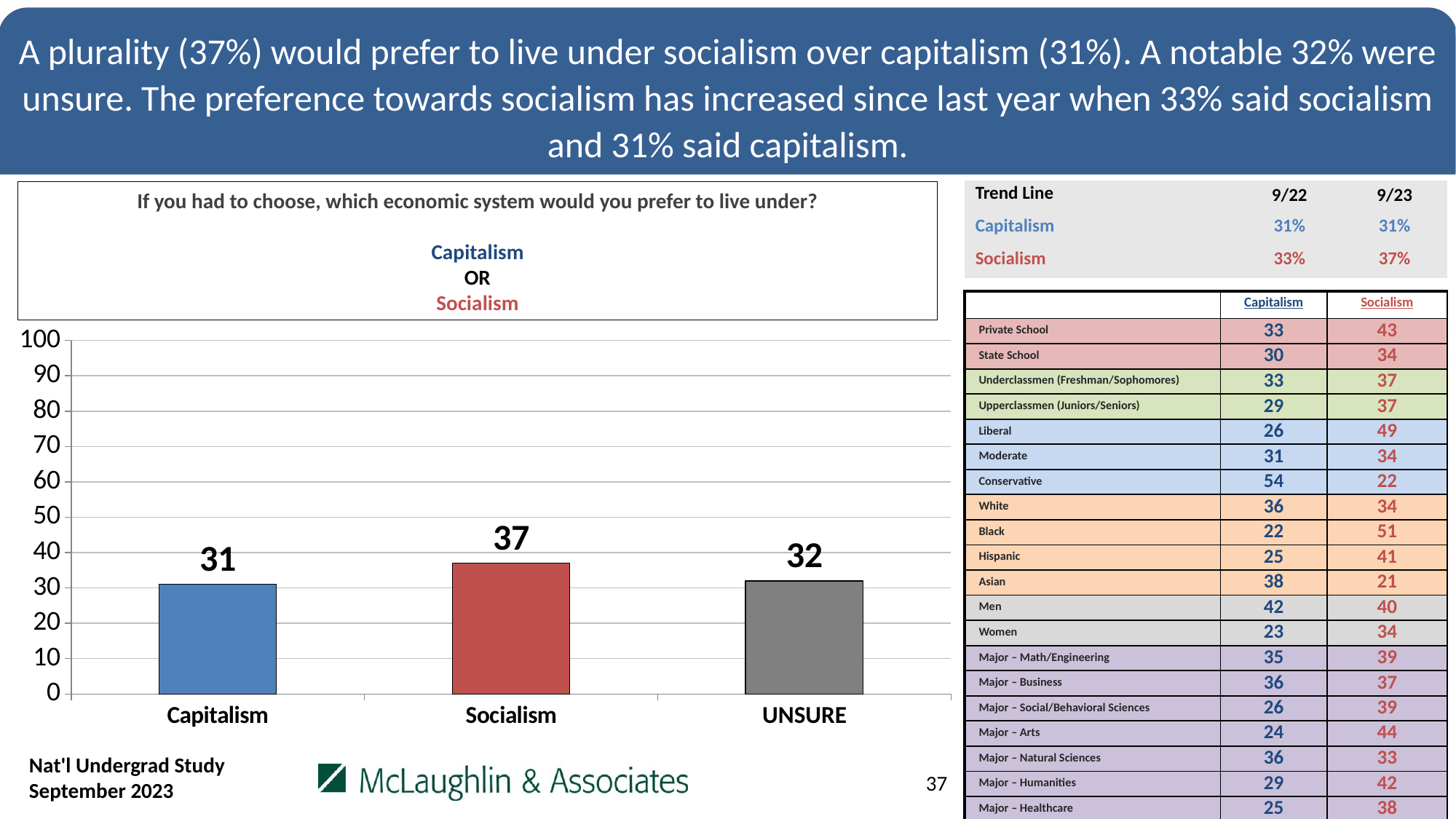
Is the value for Socialism in the bar chart greater or less than 50? less What is the difference between the UNSURE and Capitalism values in the bar chart? 1 What is the value for Capitalism in the bar chart? 31 What is the maximum value shown on the y axis of the bar chart? 100 What is the difference between the Socialism and Capitalism values in the bar chart? 6 Which is larger in the bar chart, Socialism or UNSURE? Socialism What kind of chart is shown on the slide? bar chart Which category has the lowest value in the bar chart? Capitalism What is the value for Socialism in the bar chart? 37 How many categories are shown in the bar chart? 3 Which category has the highest value in the bar chart? Socialism What is the value for UNSURE in the bar chart? 32